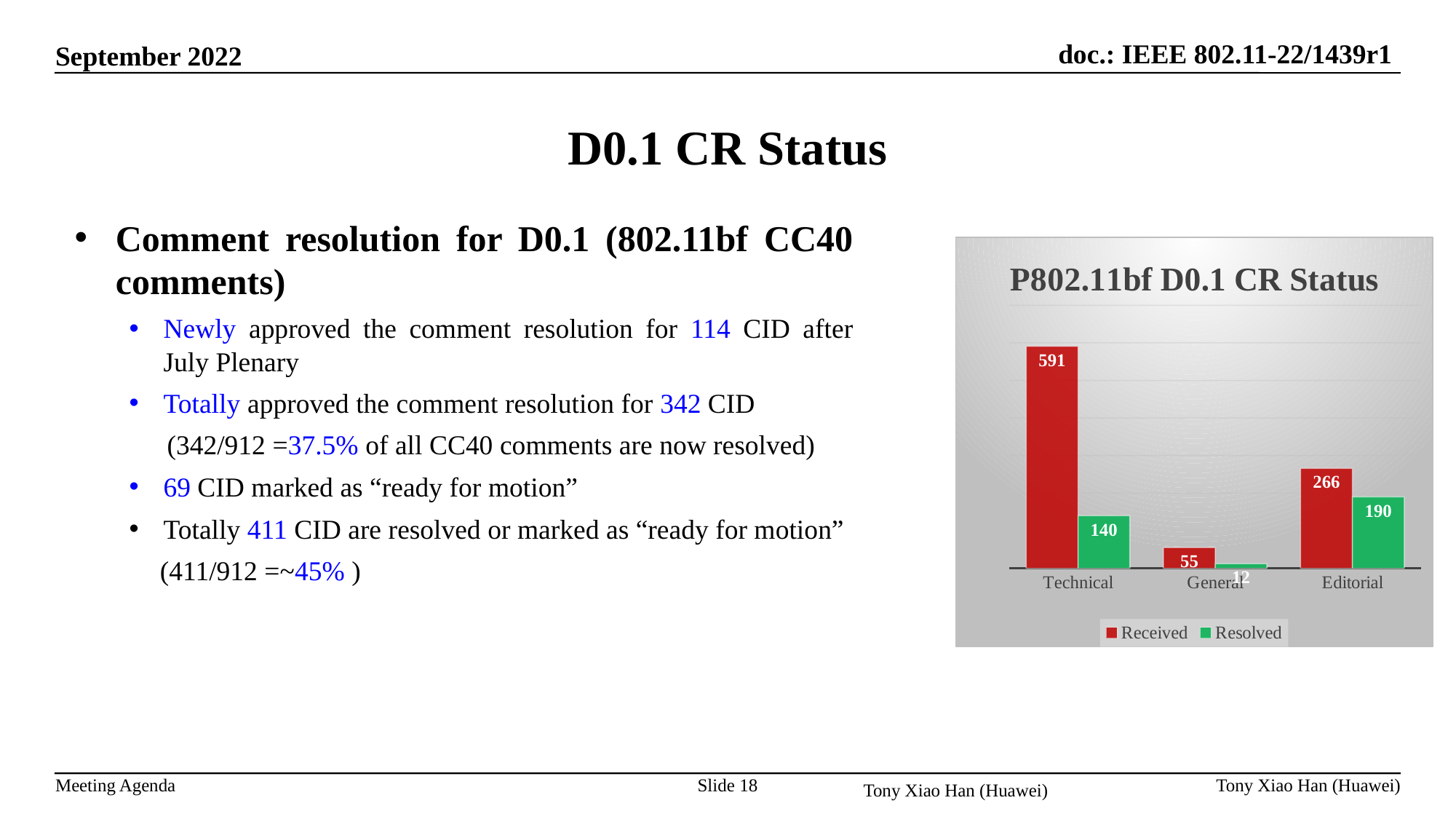
What kind of chart is shown on the slide? bar chart How many categories are shown on the x axis of the chart? 3 What is the difference between the Received and Resolved values for Editorial? 76 What is the Resolved value for Technical? 140 Which is larger, the Resolved value for Editorial or the Resolved value for Technical? Editorial What is the title of the chart? P802.11bf D0.1 CR Status What is the Received value for General? 55 Which category has the highest Received value? Technical How many series does the chart's legend list? 2 What is the Resolved value for Editorial? 190 What is the Received value for Technical? 591 Which category has the lowest Resolved value? General